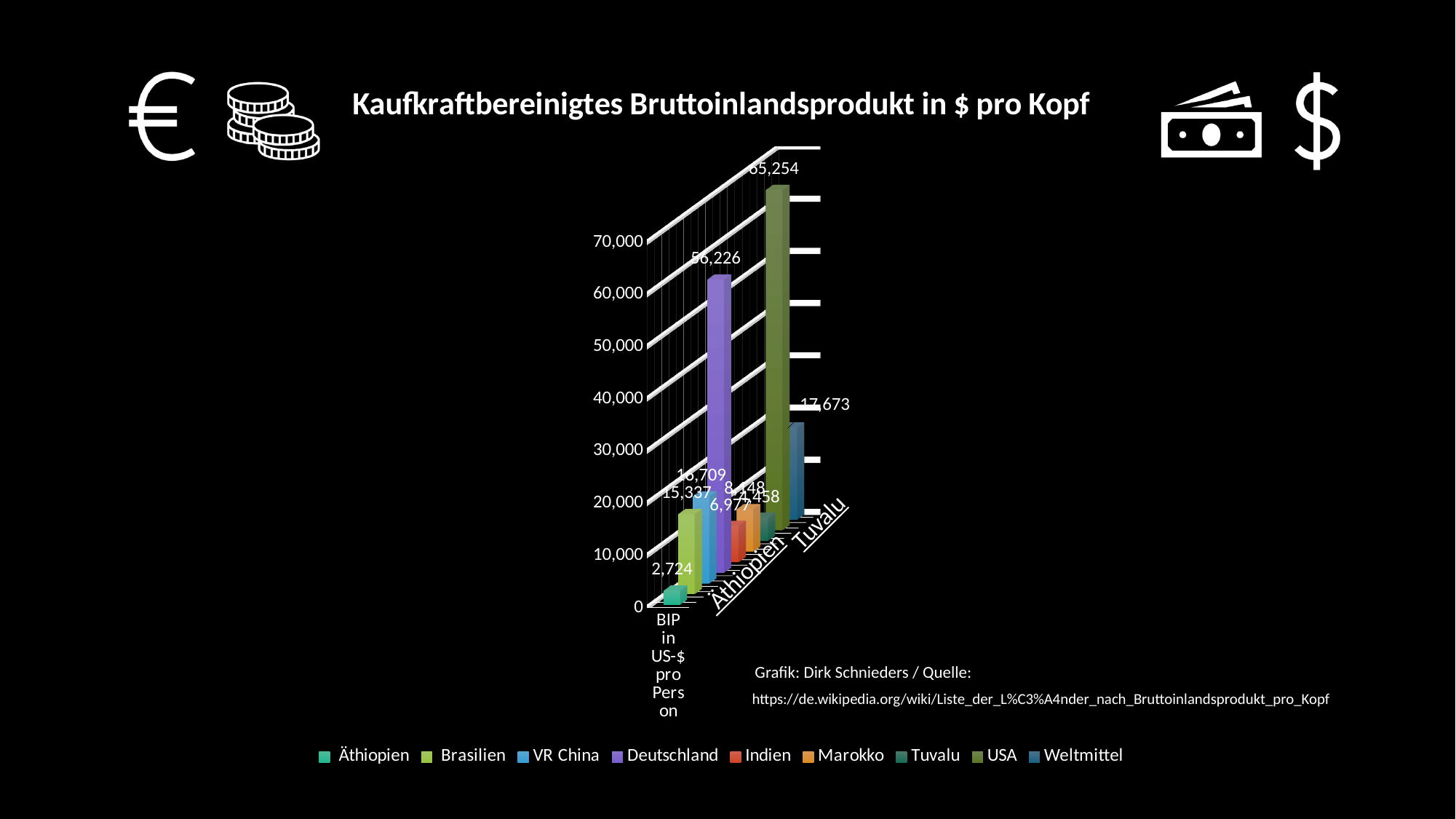
What is the value shown for USA? 65,254 What is the value shown for Weltmittel? 17,673 What is the value shown for Äthiopien? 2,724 What is the value shown for Brasilien? 15,337 What kind of chart is shown on the slide? bar chart What is the title of the chart? Kaufkraftbereinigtes Bruttoinlandsprodukt in $ pro Kopf Which country has the highest value in the chart? USA Which country has the lowest value in the chart? Äthiopien What is the value shown for Deutschland? 56,226 What is the difference between the values for USA and Deutschland? 9,028 How many series does the legend list? 9 Which is larger, the value for Brasilien or the value for VR China? VR China